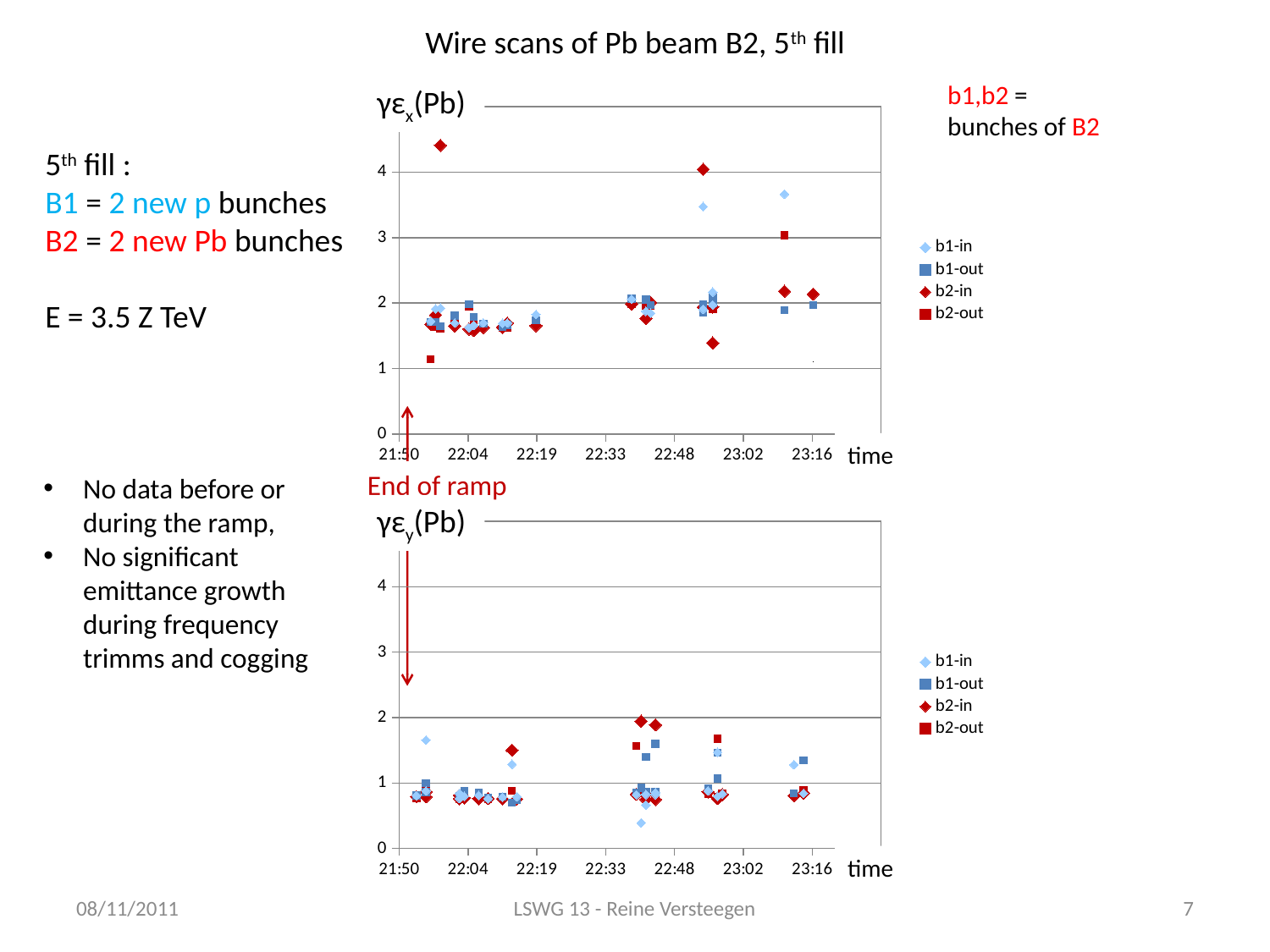
How many series does the legend of the bottom chart, γεy(Pb), list? 4 In the top chart, γεx(Pb), is the highest b2-in point (near 21:57) greater or less than 4? greater How many series does the legend of the top chart, γεx(Pb), list? 4 In the top chart, γεx(Pb), is the b1-in point near 22:55 greater or less than 3? greater What kind of chart is the top chart, γεx(Pb)? scatter chart In the top chart, γεx(Pb), which series has the highest plotted point? b2-in What is the label on the x axis of the bottom chart, γεy(Pb)? time In the bottom chart, γεy(Pb), which series has the highest plotted point? b2-in In the top chart, γεx(Pb), is the b1-in point near 23:10 greater or less than 3? greater In the bottom chart, γεy(Pb), which series has the lowest plotted point? b1-in